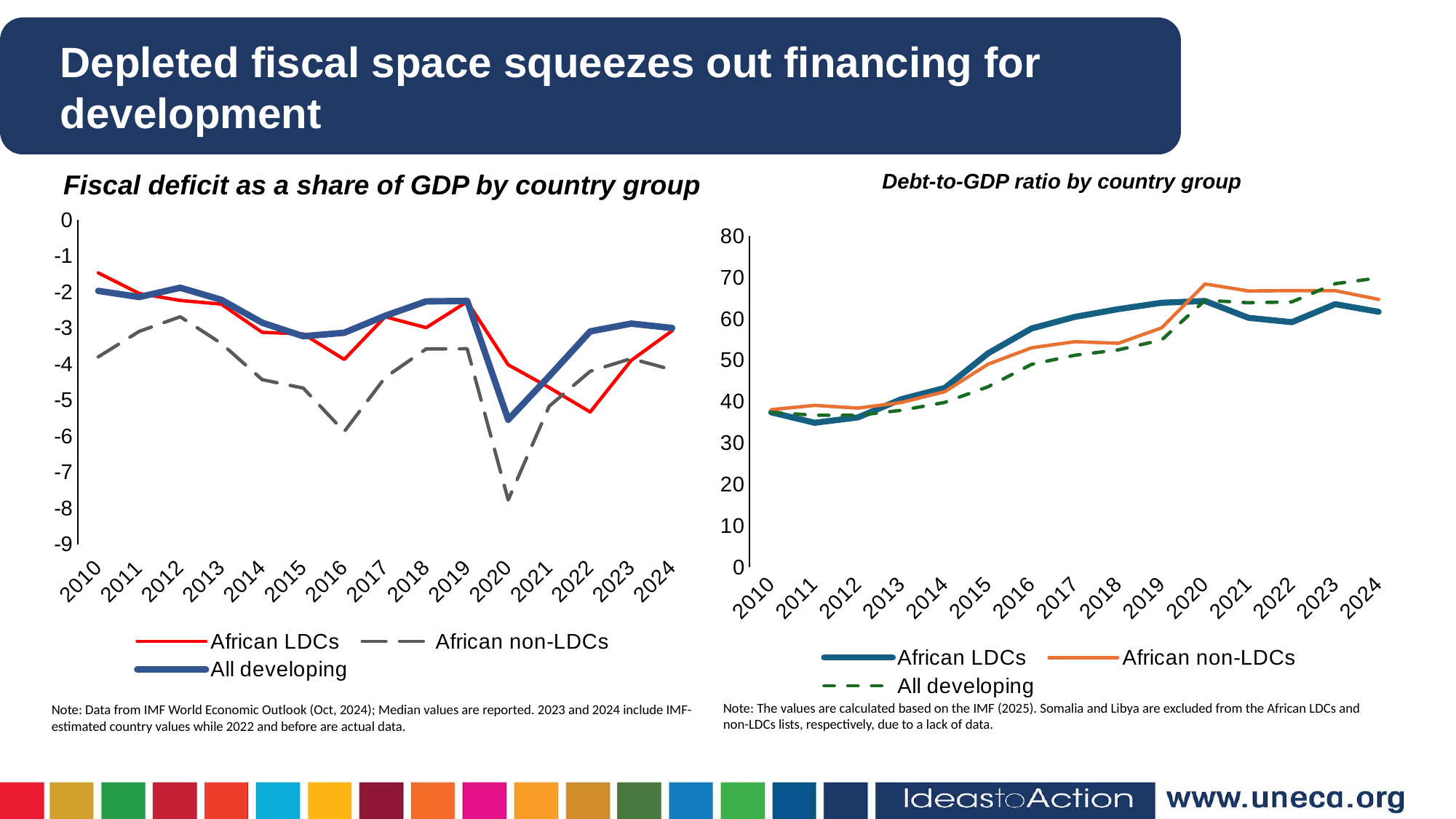
In the 'Fiscal deficit as a share of GDP by country group' chart, which series has the lowest value in 2020? African non-LDCs In the 'Debt-to-GDP ratio by country group' chart, is the value for African non-LDCs in 2020 greater or less than 60? greater In the 'Debt-to-GDP ratio by country group' chart, do the values for African LDCs generally rise or fall from 2010 to 2024? rise How many years are plotted on the x axis of the 'Fiscal deficit as a share of GDP by country group' chart? 15 What kind of chart is the 'Fiscal deficit as a share of GDP by country group' chart? line chart In the 'Debt-to-GDP ratio by country group' chart, which series is drawn with a dashed line? All developing In the 'Fiscal deficit as a share of GDP by country group' chart, which year has the lowest value for African non-LDCs? 2020 In the 'Fiscal deficit as a share of GDP by country group' chart, is the value for All developing in 2020 greater or less than -5? less In the 'Fiscal deficit as a share of GDP by country group' chart, is the value for African non-LDCs in 2020 greater or less than -7? less How many series does the legend of the 'Debt-to-GDP ratio by country group' chart list? 3 In the 'Fiscal deficit as a share of GDP by country group' chart, which is larger in 2020: African LDCs or All developing? African LDCs In the 'Debt-to-GDP ratio by country group' chart, which is larger in 2024: All developing or African LDCs? All developing